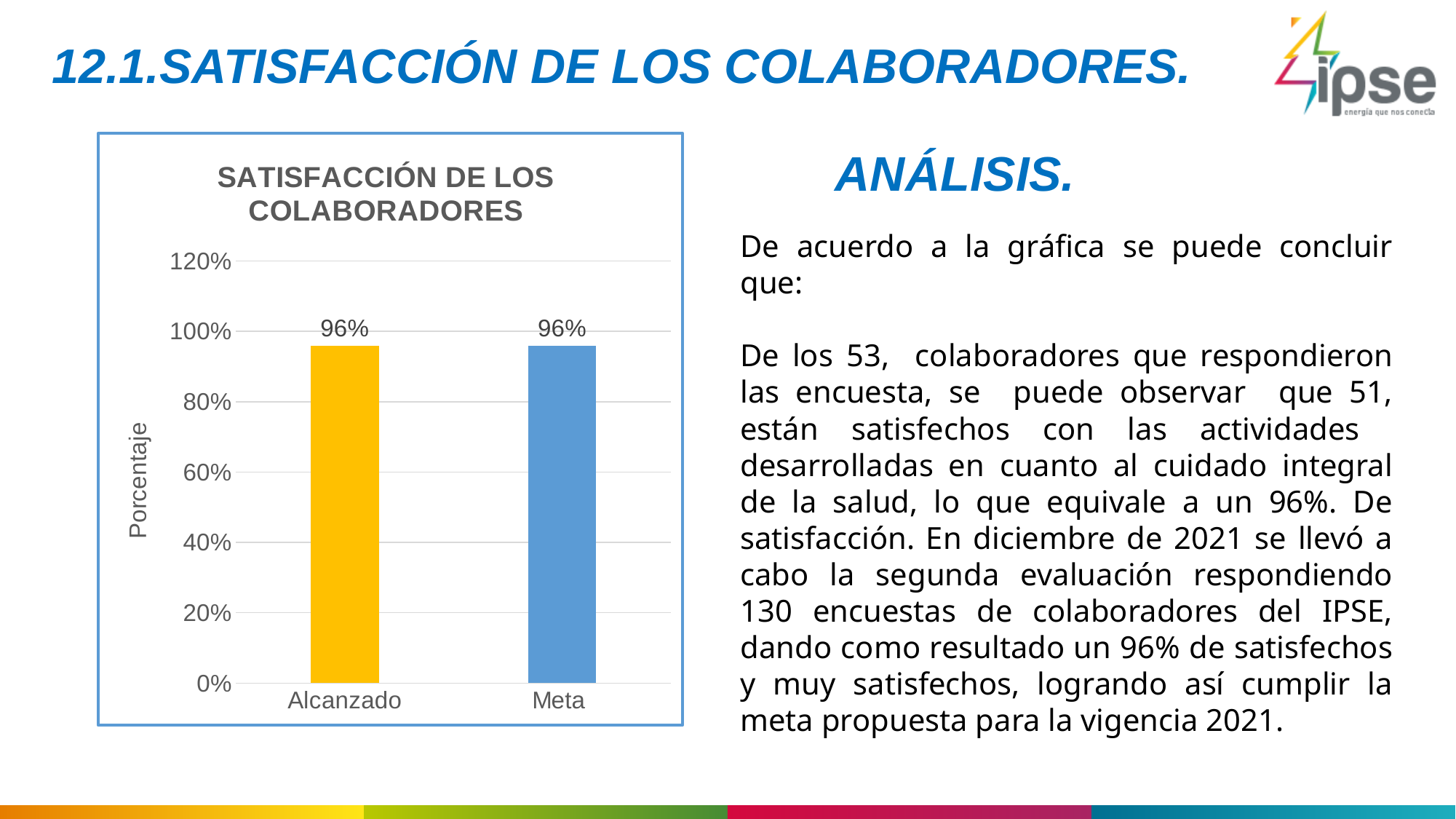
What is the title of the chart? SATISFACCIÓN DE LOS COLABORADORES Is the value for Meta greater or less than 100%? less What is the value for Meta? 96% How many categories are shown on the x axis? 2 What is the difference between the Alcanzado and Meta values? 0% What is the highest value shown on the vertical axis? 120% Is the value for Alcanzado greater or less than 80%? greater What kind of chart is shown on the slide? bar chart What is the value for Alcanzado? 96% What is the label of the vertical axis? Porcentaje